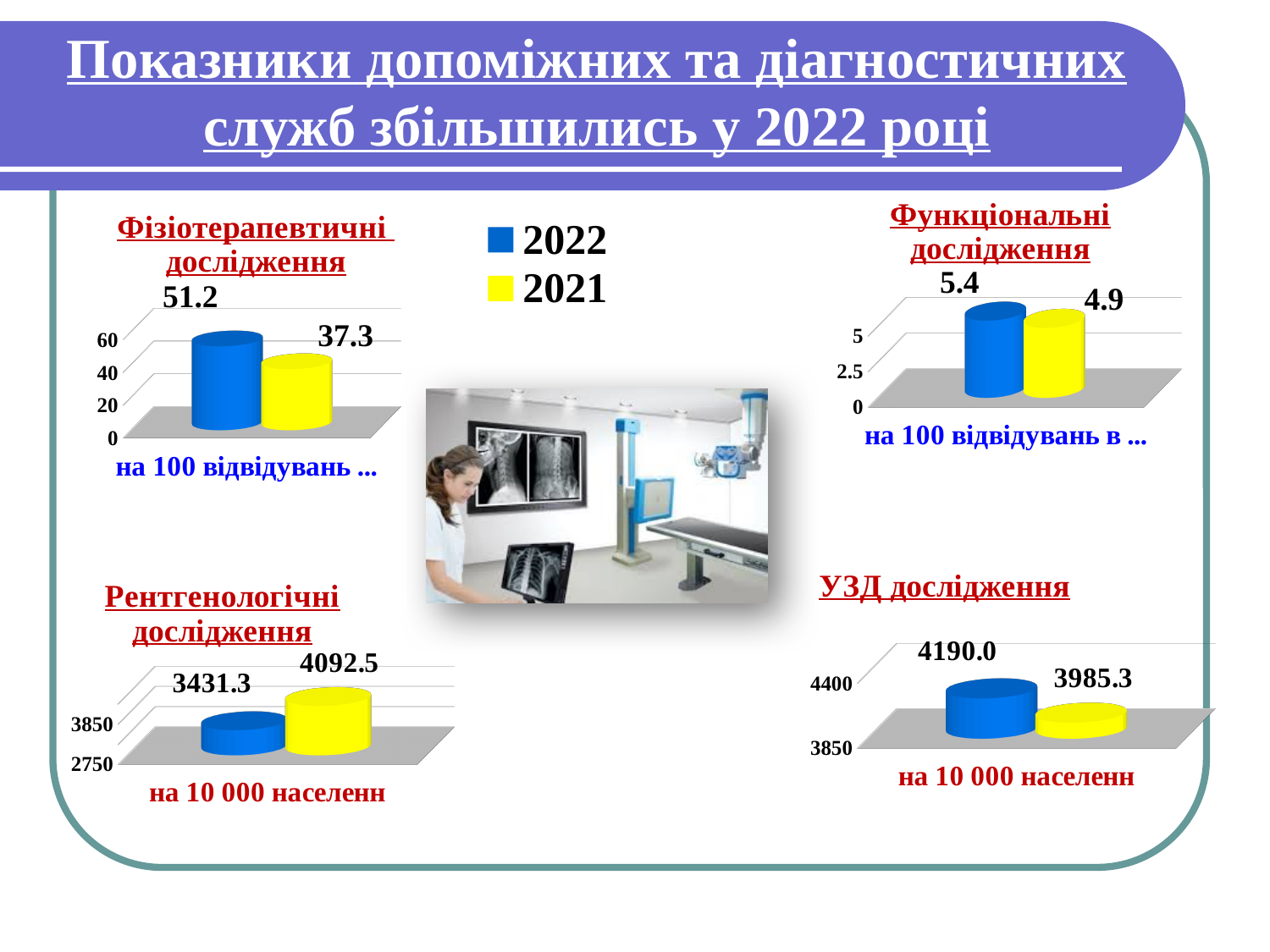
Which colour represents 2021 in the legend? Yellow In the 'Функціональні дослідження' chart, what is the difference between the 2022 and 2021 values? 0.5 In the 'Рентгенологічні дослідження' chart, which year has the higher value, 2022 or 2021? 2021 What type of chart is the 'УЗД дослідження' chart? Bar chart In the 'Рентгенологічні дослідження' chart, what is the value for 2021 (yellow bar)? 4092.5 In the 'УЗД дослідження' chart, what is the value for 2021? 3985.3 In the 'Функціональні дослідження' chart, what is the value for 2022? 5.4 In the 'УЗД дослідження' chart, what is the value for 2022? 4190.0 In the 'Фізіотерапевтичні дослідження' chart, what is the difference between the 2022 and 2021 values? 13.9 In the 'Фізіотерапевтичні дослідження' chart, what is the value for 2022? 51.2 In the 'Фізіотерапевтичні дослідження' chart, what is the value for 2021? 37.3 How many series does the shared legend list? 2